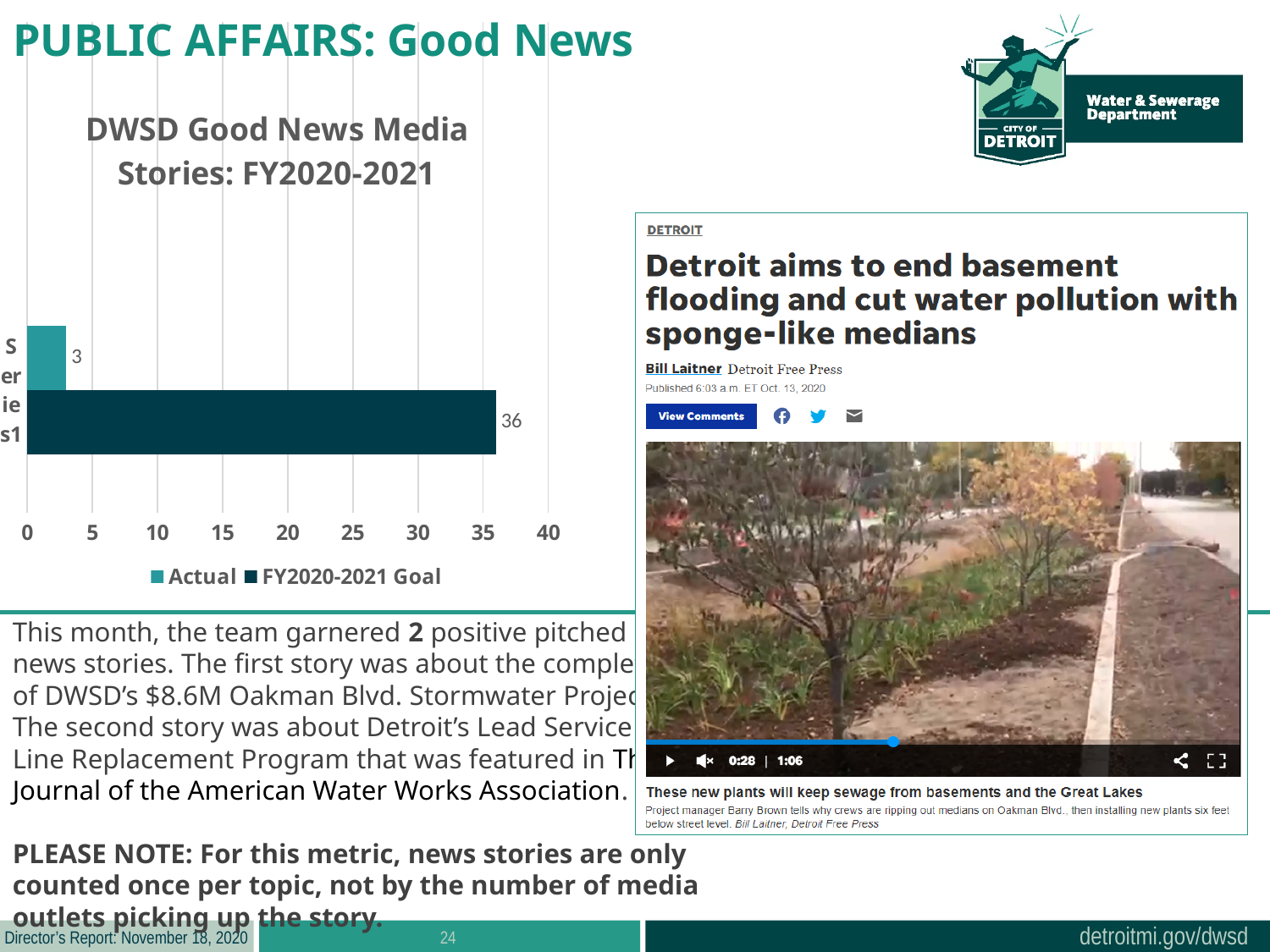
What is the maximum value shown on the x axis of the chart? 40 Which series has the highest value in the DWSD Good News Media Stories chart? FY2020-2021 Goal Which series has the lowest value in the DWSD Good News Media Stories chart? Actual How many series does the legend of the DWSD Good News Media Stories chart list? 2 Is the FY2020-2021 Goal value in the chart greater or less than 30? greater Which is larger in the chart, the Actual value or the FY2020-2021 Goal? FY2020-2021 Goal What is the value of the FY2020-2021 Goal bar in the DWSD Good News Media Stories chart? 36 What is the difference between the FY2020-2021 Goal and the Actual value in the chart? 33 Is the Actual value in the chart greater or less than 5? less What is the title of the chart on the slide? DWSD Good News Media Stories: FY2020-2021 What type of chart is used to show the DWSD Good News Media Stories? Bar chart What is the value of the Actual bar in the DWSD Good News Media Stories chart? 3